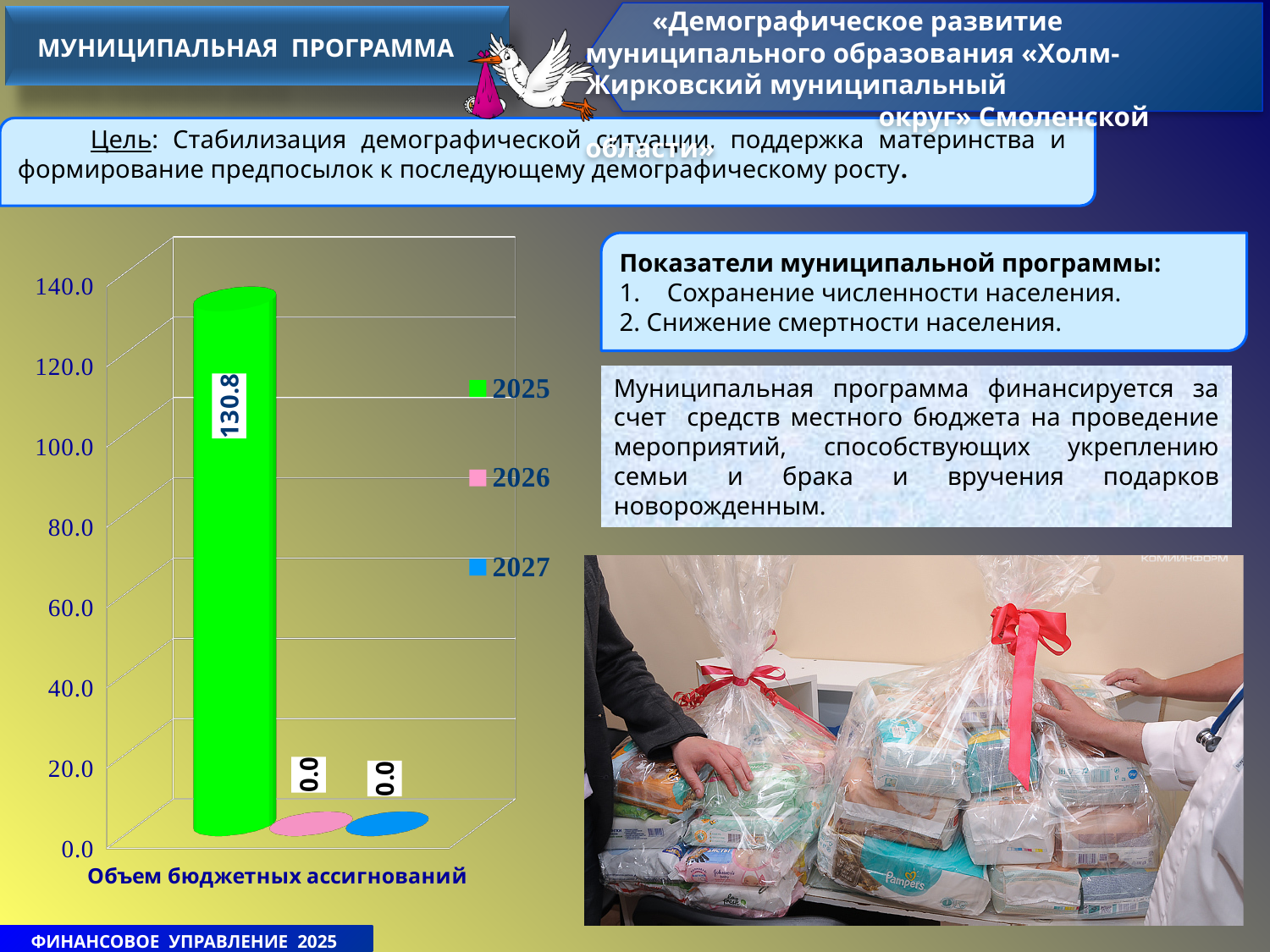
Which is larger, the value for 2025 or the value for 2027? 2025 What is the difference between the values for 2025 and 2026? 130.8 Is the value for 2025 greater or less than 120.0? greater What is the value for 2025 in the chart? 130.8 How many series does the legend list? 3 What is the highest tick value shown on the vertical axis? 140.0 What colour is the bar for 2025? green What is the category label shown under the chart? Объем бюджетных ассигнований What kind of chart is shown on the slide? bar chart What is the value for 2026 in the chart? 0.0 What is the value for 2027 in the chart? 0.0 Which year has the highest value in the chart? 2025